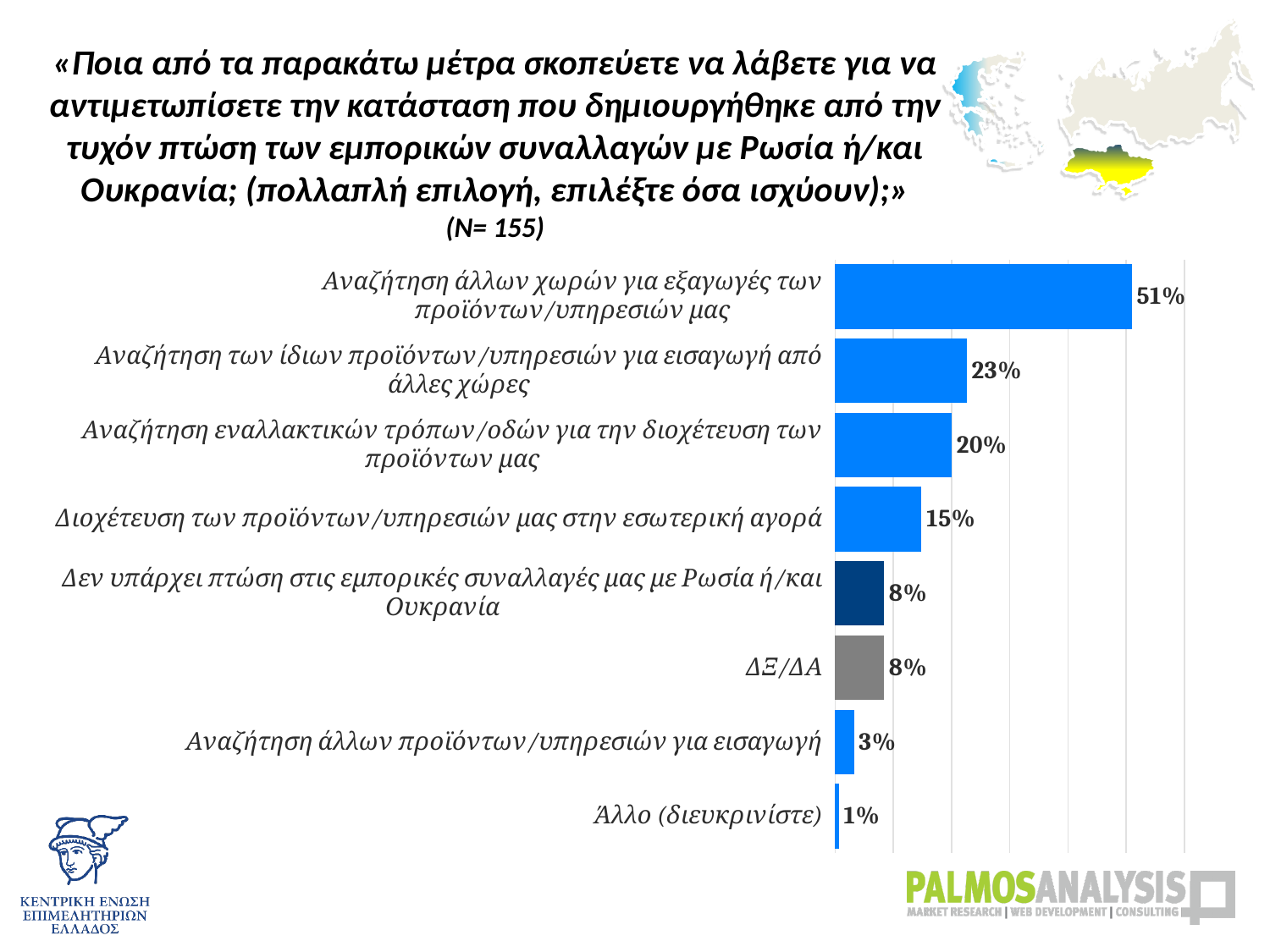
How many categories are shown in the chart? 8 What percentage is shown for "Αναζήτηση άλλων χωρών για εξαγωγές των προϊόντων/υπηρεσιών μας"? 51% What type of chart is shown on the slide? Bar chart What sample size (N) is stated in the chart title? 155 Which is larger: the value for "Αναζήτηση των ίδιων προϊόντων/υπηρεσιών για εισαγωγή από άλλες χώρες" or for "Αναζήτηση εναλλακτικών τρόπων/οδών για την διοχέτευση των προϊόντων μας"? Αναζήτηση των ίδιων προϊόντων/υπηρεσιών για εισαγωγή από άλλες χώρες What is the difference between the values for "Αναζήτηση εναλλακτικών τρόπων/οδών για την διοχέτευση των προϊόντων μας" and "Διοχέτευση των προϊόντων/υπηρεσιών μας στην εσωτερική αγορά"? 5% What is the value for "Διοχέτευση των προϊόντων/υπηρεσιών μας στην εσωτερική αγορά"? 15% What is the value for "Αναζήτηση άλλων προϊόντων/υπηρεσιών για εισαγωγή"? 3% Which category has the highest value in the chart? Αναζήτηση άλλων χωρών για εξαγωγές των προϊόντων/υπηρεσιών μας What percentage is shown for "ΔΞ/ΔΑ"? 8% Which category has the lowest value in the chart? Άλλο (διευκρινίστε) What is the difference between the values for "Αναζήτηση άλλων χωρών για εξαγωγές των προϊόντων/υπηρεσιών μας" and "Αναζήτηση των ίδιων προϊόντων/υπηρεσιών για εισαγωγή από άλλες χώρες"? 28%